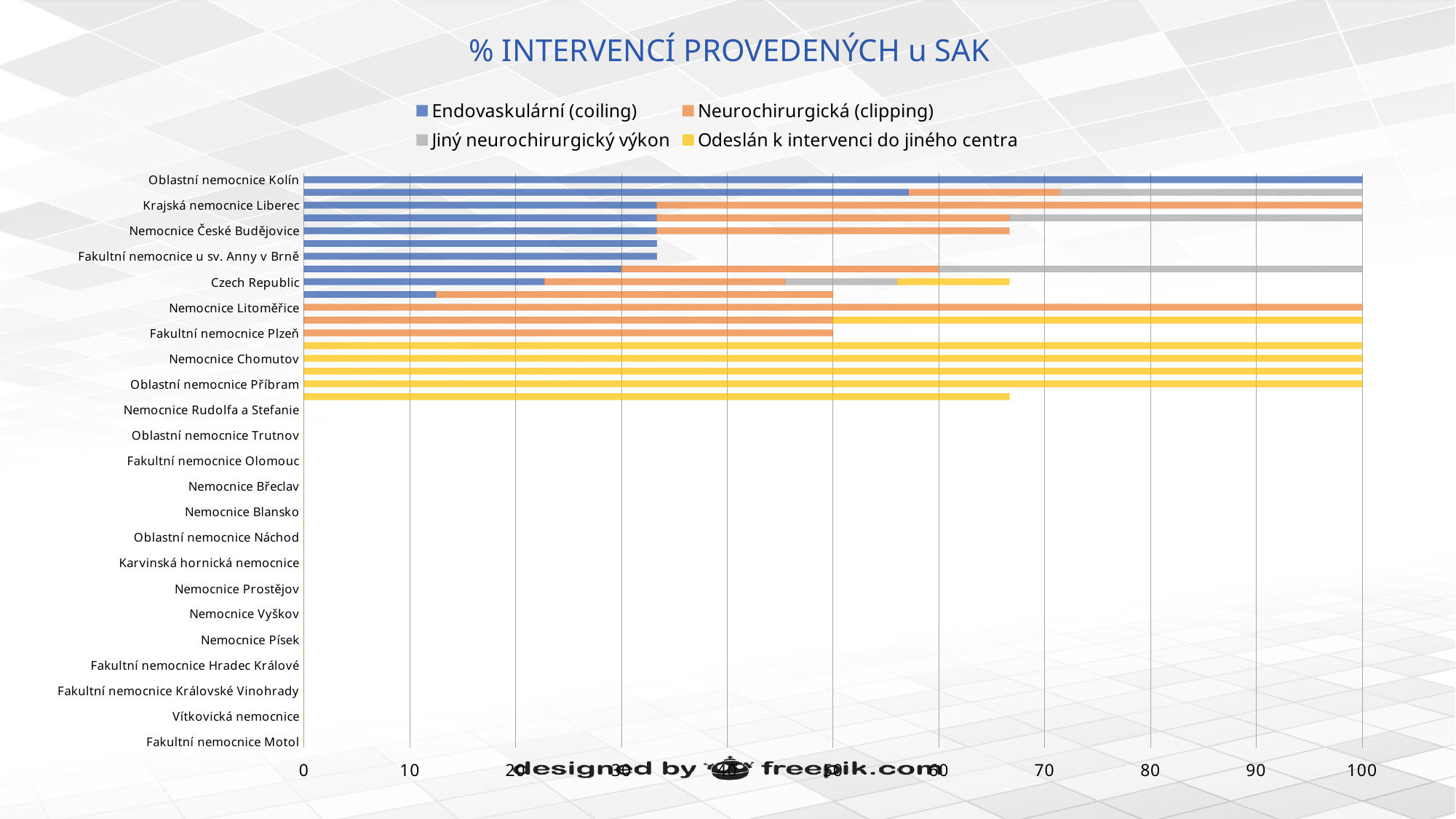
Which series is shown in yellow in the legend? Odeslán k intervenci do jiného centra What is the title of the chart? % INTERVENCÍ PROVEDENÝCH u SAK What is the value of Odeslán k intervenci do jiného centra for Nemocnice Chomutov? 100 What kind of chart is shown on the slide? bar chart Is the value of Endovaskulární (coiling) for Krajská nemocnice Liberec greater or less than 20? greater How many series does the legend list? 4 What is the value of Endovaskulární (coiling) for Oblastní nemocnice Kolín? 100 Is the value of Endovaskulární (coiling) for Czech Republic greater or less than 30? less Is the value of Endovaskulární (coiling) for Fakultní nemocnice u sv. Anny v Brně greater or less than 40? less What is the value of Neurochirurgická (clipping) for Nemocnice Litoměřice? 100 What is the value of Neurochirurgická (clipping) for Fakultní nemocnice Plzeň? 50